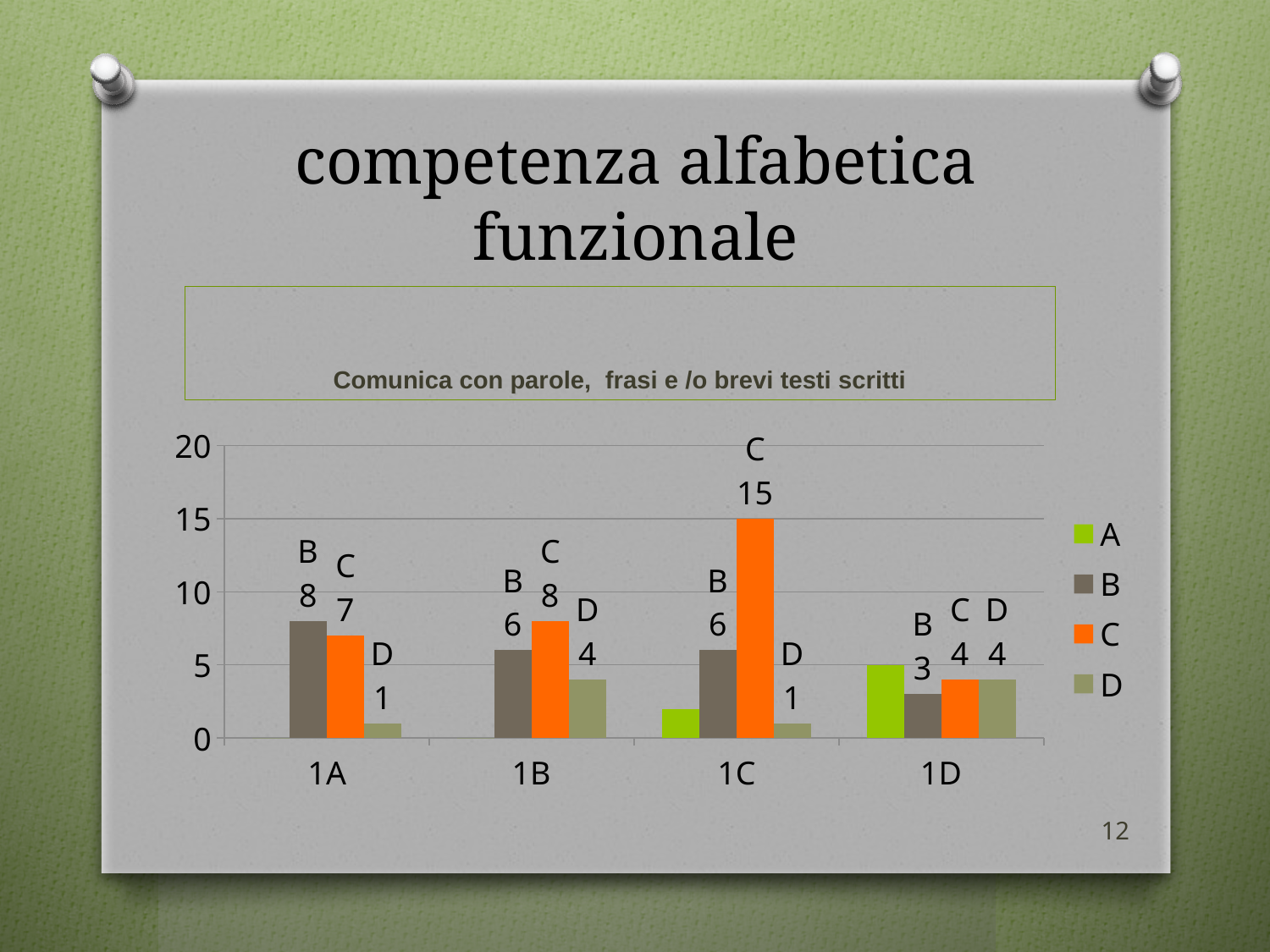
What is the value of series B for category 1A? 8 Which is larger: series B for 1A or series C for 1A? series B for 1A Is the value of series A for category 1C greater or less than 5? less What is the difference between the value of series C for 1C and the value of series C for 1B? 7 Which category has the lowest value for series B? 1D What is the value of series C for category 1C? 15 How many series does the legend list? 4 What is the value of series D for category 1B? 4 What kind of chart is shown on the slide? bar chart How many categories are shown on the x axis? 4 Which category has the highest value for series C? 1C What is the value of series B for category 1D? 3